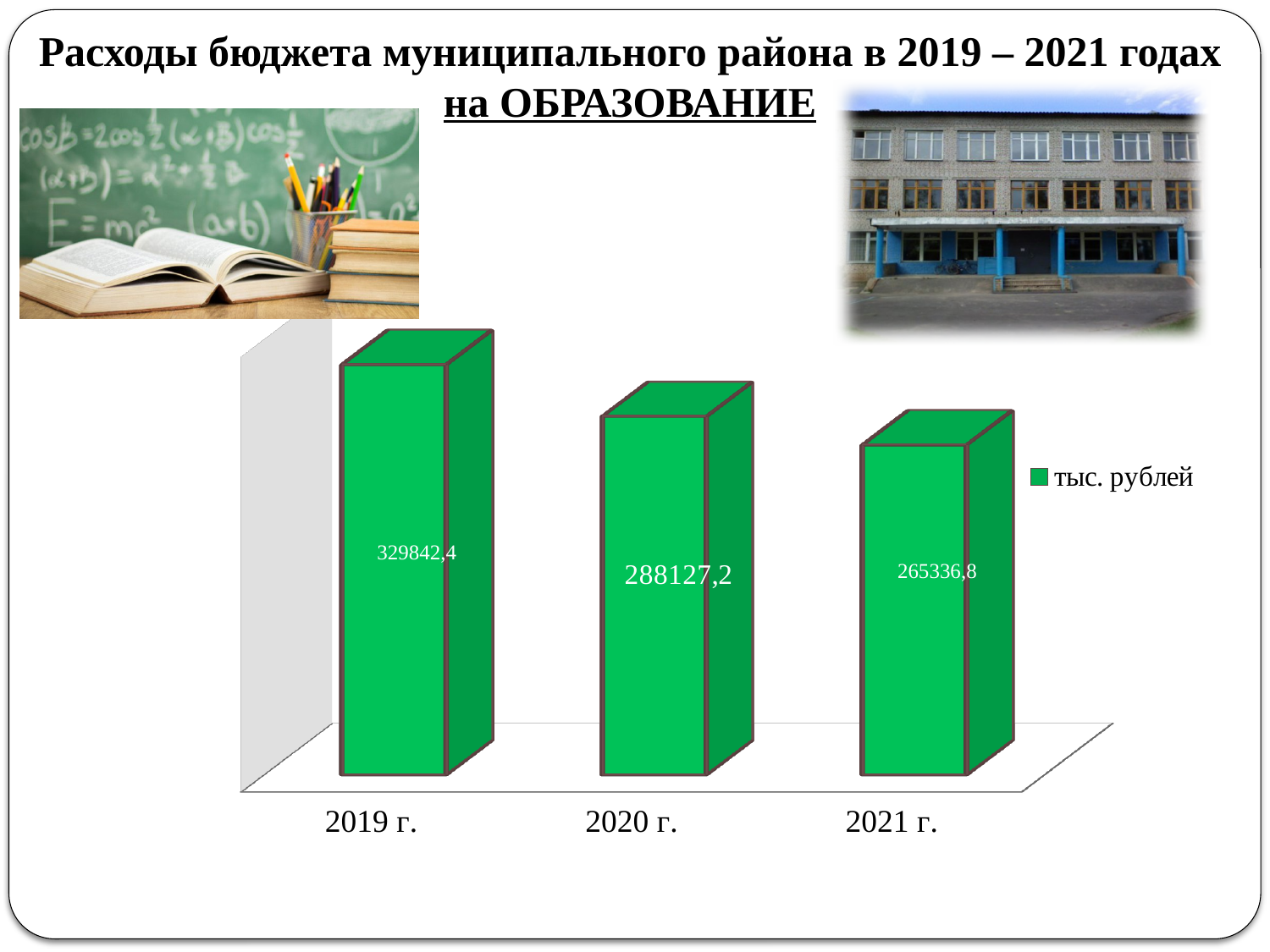
What is the difference between the values for 2020 г. and 2021 г.? 22790,4 What is the value for 2019 г.? 329842,4 Which year has the highest value? 2019 г. How many series does the legend list? 1 What is the value for 2021 г.? 265336,8 Do the values rise or fall from 2019 г. to 2021 г.? fall How many years are shown on the chart? 3 What is the value for 2020 г.? 288127,2 What is the difference between the values for 2019 г. and 2020 г.? 41715,2 What kind of chart is shown on the slide? bar chart Which is larger, the value for 2020 г. or the value for 2021 г.? 2020 г. Which year has the lowest value? 2021 г.